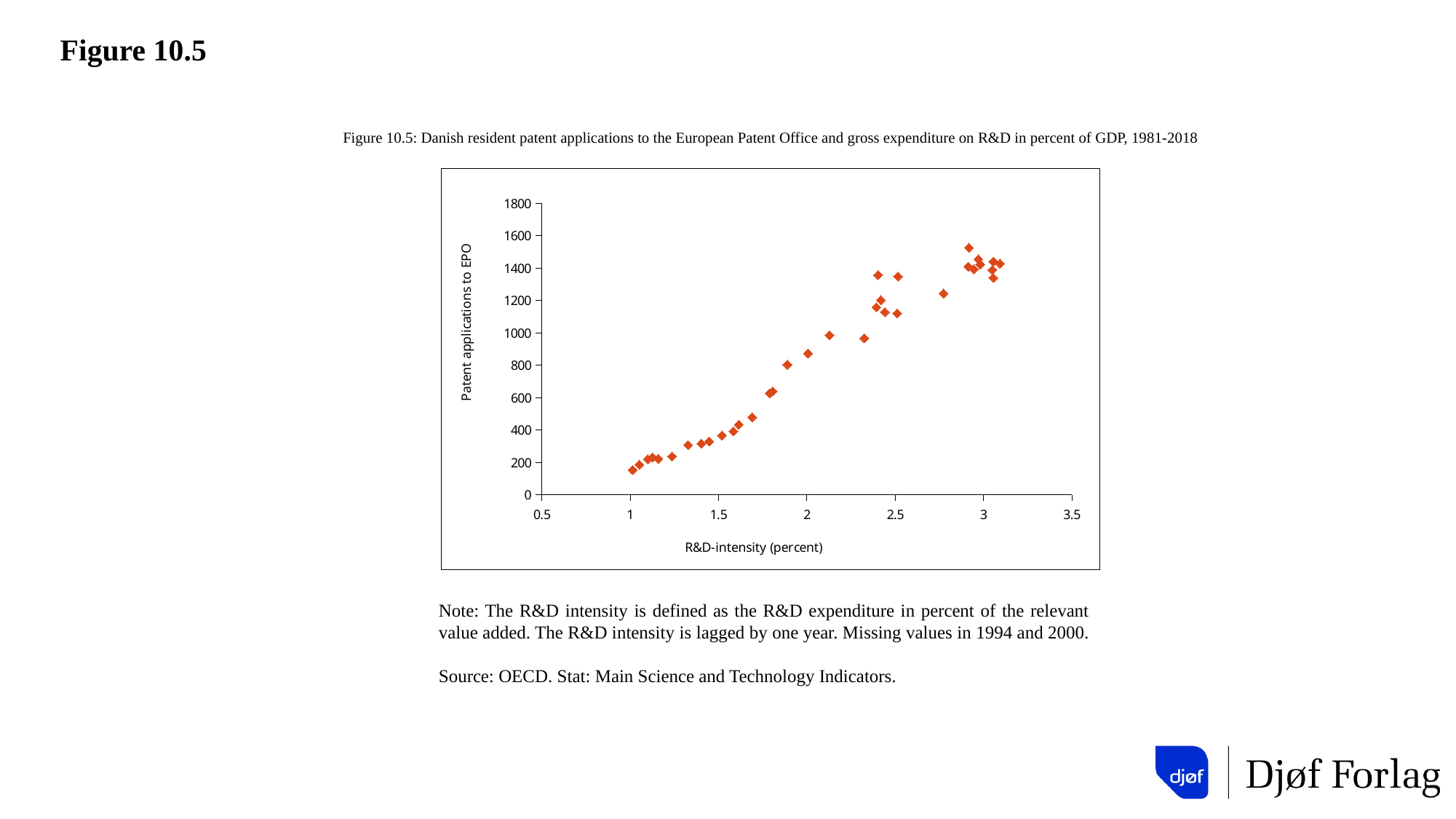
Do patent applications to EPO generally rise or fall as R&D-intensity increases along the x axis? rise Is the highest number of patent applications plotted greater or less than 1400? greater What is the label of the y axis? Patent applications to EPO Is the lowest R&D-intensity value plotted greater or less than 1.5? less Is the highest R&D-intensity value plotted greater or less than 3? greater What kind of chart is shown on the slide? scatter plot Which years does the figure title say the data cover? 1981-2018 What is the maximum value shown on the y axis? 1800